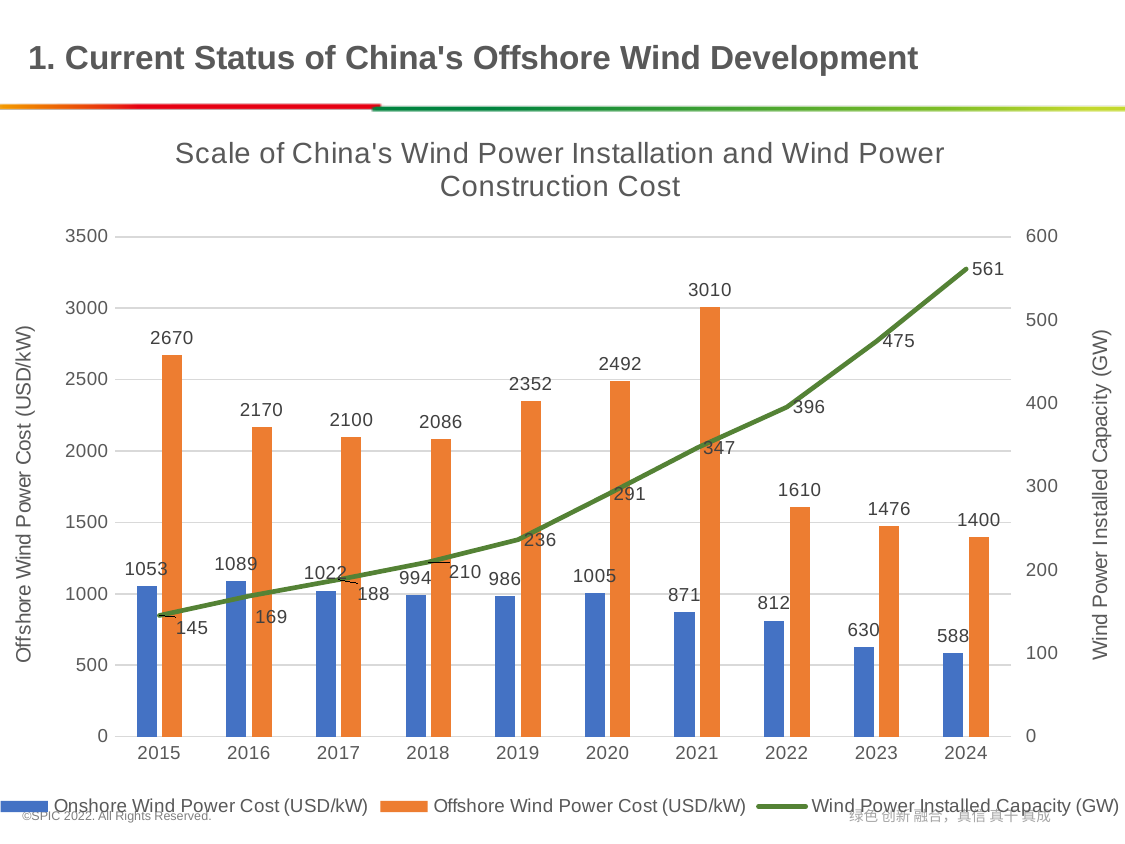
Which year has the lowest Onshore Wind Power Cost (USD/kW)? 2024 Does the Wind Power Installed Capacity (GW) rise or fall from 2015 to 2024? rise Which year has the highest Offshore Wind Power Cost (USD/kW)? 2021 What is the difference between the Offshore Wind Power Cost in 2015 and in 2016? 500 What is the Onshore Wind Power Cost (USD/kW) for 2018? 994 What is the Wind Power Installed Capacity (GW) for 2024? 561 What is the title of the chart? Scale of China's Wind Power Installation and Wind Power Construction Cost What is the Offshore Wind Power Cost (USD/kW) for 2021? 3010 How many years are shown on the x axis? 10 How many series does the legend list? 3 Which is larger, the Onshore Wind Power Cost in 2016 or in 2017? 2016 What is the difference between the Wind Power Installed Capacity in 2024 and in 2023? 86